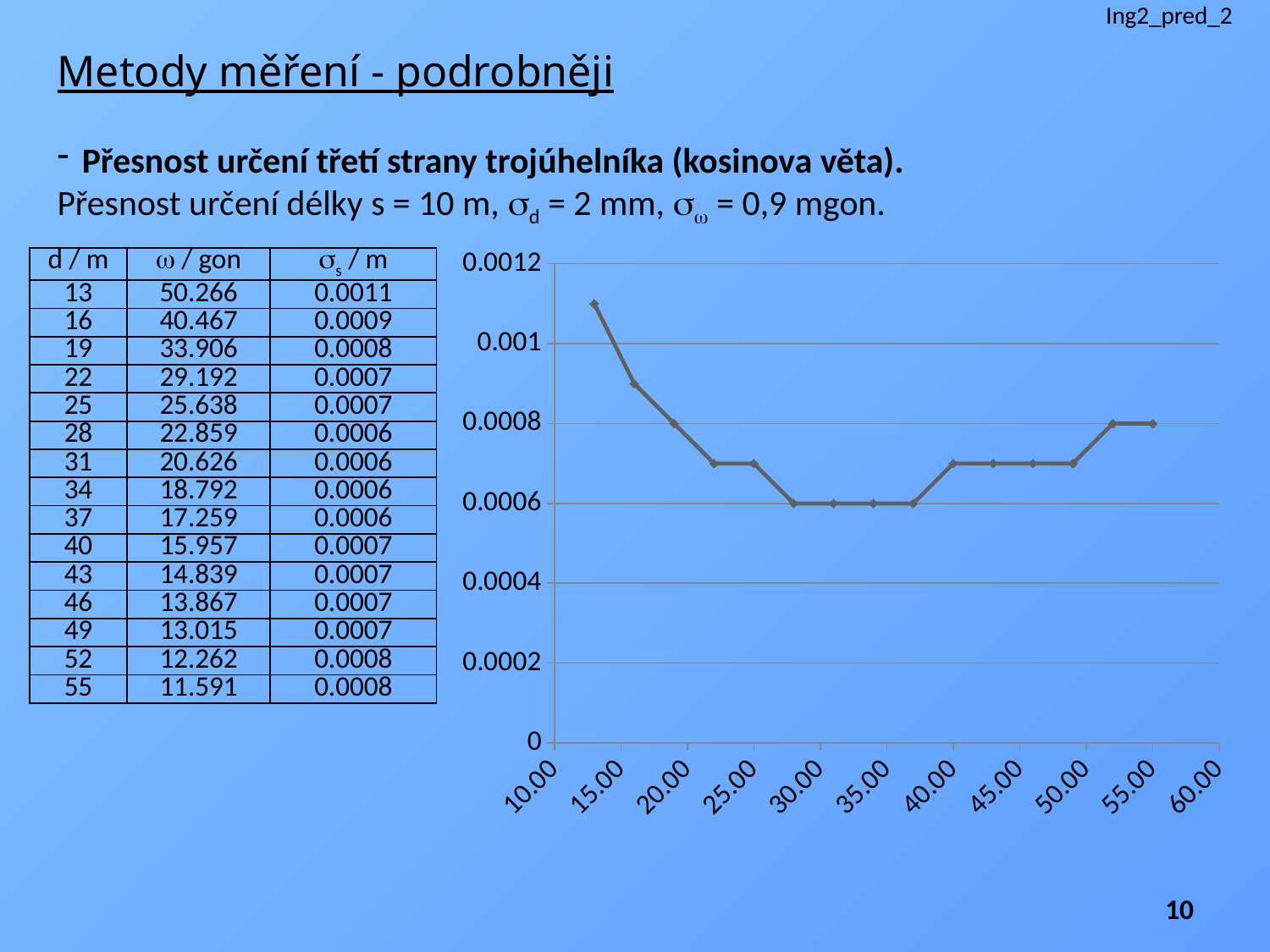
Is the value of the plotted point at d = 16 m greater or less than 0.001? less Is the value of the first plotted point (at d = 13 m) greater or less than 0.001? greater How do the plotted values change along the x axis from left to right? They fall, then rise How many data points are plotted on the chart? 15 What is the value of σs at d = 55 m? 0.0008 What is the lowest value of σs reached on the chart? 0.0006 Which is larger, the value of σs at d = 13 m or at d = 55 m? d = 13 m Is the value of the plotted point at d = 22 m greater or less than 0.0008? less What is the value of σs at d = 13 m, the highest point on the chart? 0.0011 What kind of chart is shown on the slide? line chart What is the difference between the value of σs at d = 13 m and at d = 55 m? 0.0003